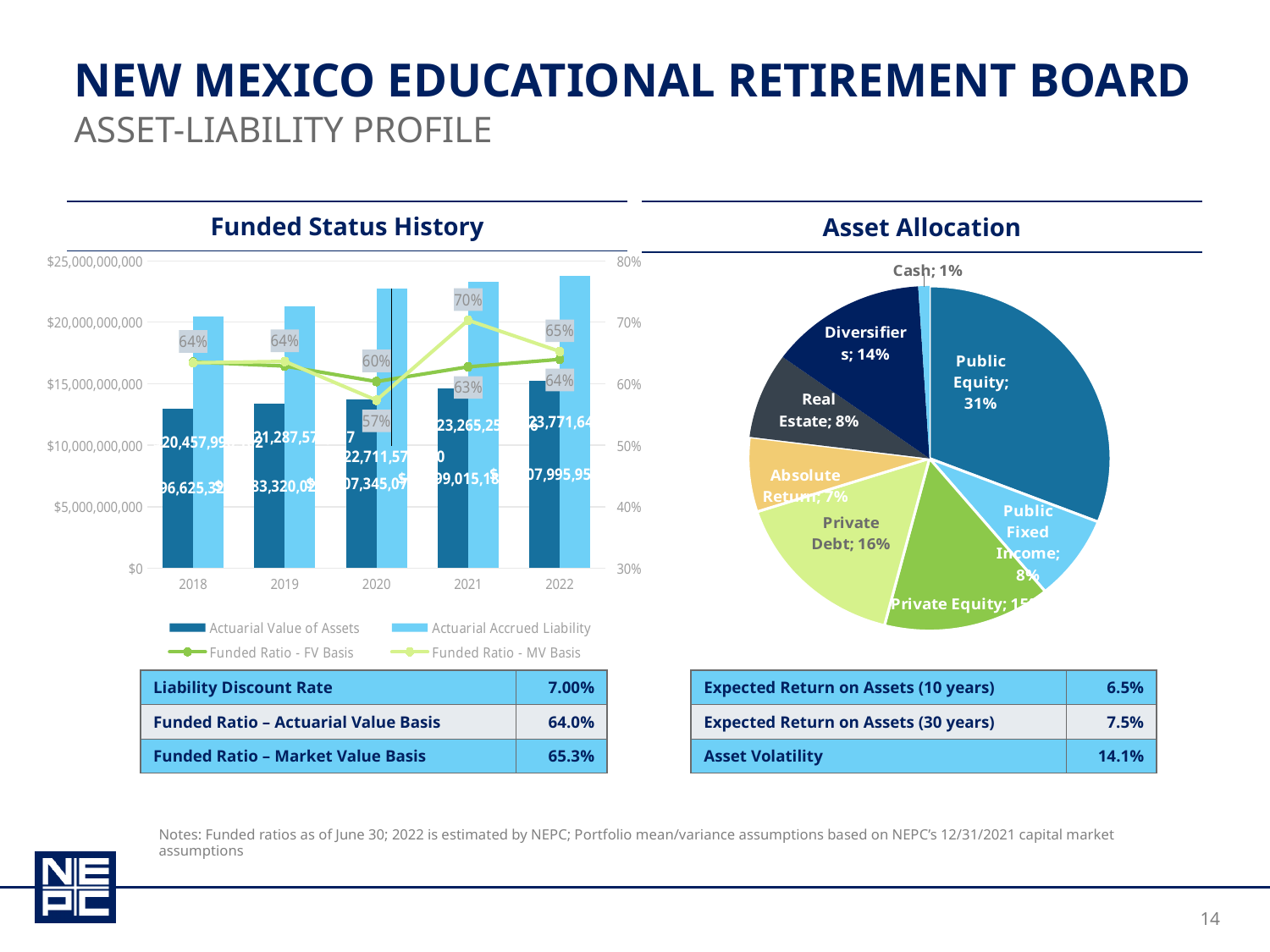
In the Asset Allocation chart, which asset class has the smallest slice? Cash How many slices does the Asset Allocation pie chart have? 8 In the Asset Allocation chart, which asset class has the largest slice? Public Equity In the Funded Status History chart, what is the Funded Ratio - MV Basis for 2021? 70% In the Funded Status History chart, is the Actuarial Accrued Liability for 2022 greater or less than $20,000,000,000? greater How many years are shown on the x axis of the Funded Status History chart? 5 In the Funded Status History chart, does the Actuarial Accrued Liability rise or fall from 2018 to 2022? Rises How many series does the legend of the Funded Status History chart list? 4 In the Asset Allocation chart, what is the difference in percentage points between Public Equity and Private Debt? 15 percentage points In the Asset Allocation chart, which is larger: Private Debt or Diversifiers? Private Debt In the Asset Allocation chart, what share of the portfolio is Public Equity? 31% What kind of chart is the Asset Allocation chart? Pie chart